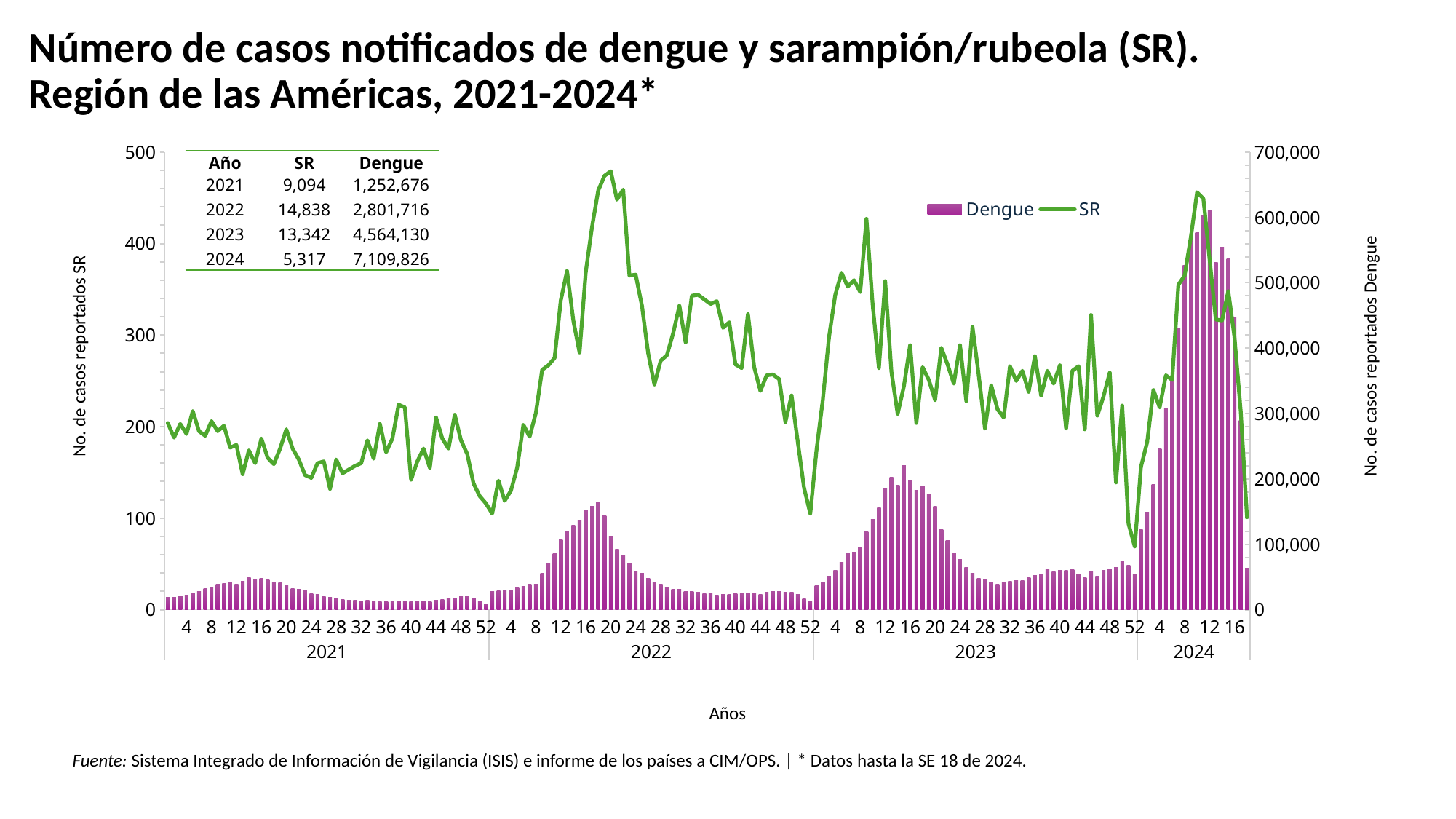
According to the inset table, which year had the highest number of SR cases? 2022 According to the inset table, which year had the lowest number of SR cases? 2024 According to the inset table, what is the difference between SR cases in 2022 and 2023? 1,496 How many years are labelled along the x axis of the chart? 4 Is the highest Dengue bar in 2021 greater or less than 100,000? less According to the inset table, how many SR cases were reported in 2021? 9,094 Is the peak value of the SR line in 2022 greater or less than 400? greater According to the inset table, which year had more Dengue cases, 2022 or 2023? 2023 How many series does the chart legend list? 2 According to the inset table, do annual Dengue cases rise or fall from 2021 to 2024? rise What kind of chart is used to show the Dengue and SR cases? A combined bar and line chart (bars for Dengue, line for SR) According to the inset table, how many Dengue cases were reported in 2024? 7,109,826